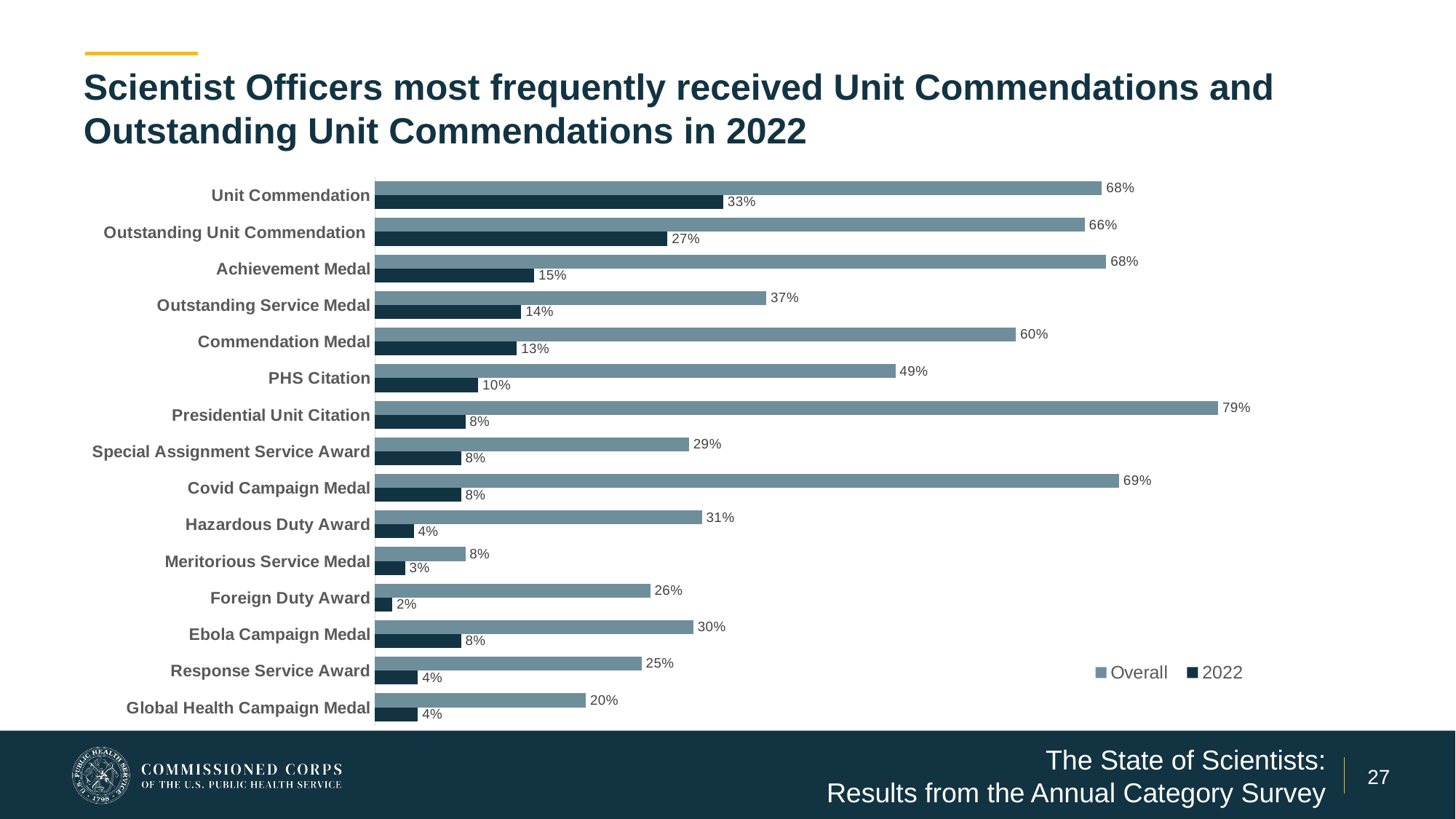
Which category has the highest 2022 value? Unit Commendation How many award categories are shown in the chart? 15 What is the difference between the Overall and 2022 values for Unit Commendation? 35% How many series does the legend list? 2 Which category has the highest Overall value? Presidential Unit Citation What is the Overall value for Commendation Medal? 60% What is the Overall value for Presidential Unit Citation? 79% What kind of chart is shown on the slide? Bar chart What is the 2022 value for Outstanding Unit Commendation? 27% What are the two series named in the legend? Overall and 2022 Which category has the lowest 2022 value? Foreign Duty Award Which is larger, the Overall value for Covid Campaign Medal or the Overall value for Outstanding Service Medal? Covid Campaign Medal